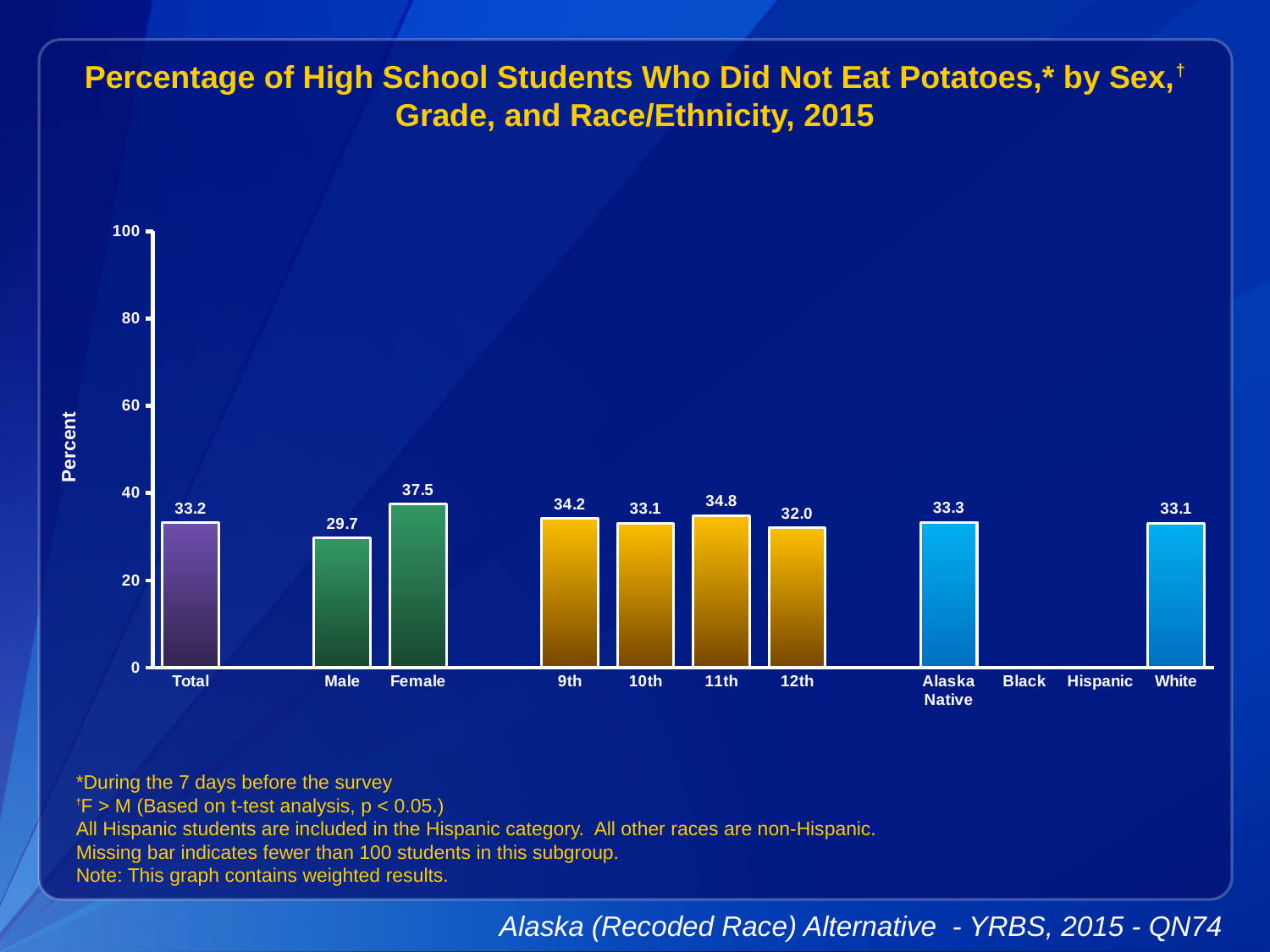
What is the difference between the Female and Male values? 7.8 Which category has the lowest value among the bars shown? Male Which is larger, the value for 9th grade or the value for 12th grade? 9th Is the value for Total greater or less than 40? less What is the value for 11th grade? 34.8 What is the difference between the 11th grade and 12th grade values? 2.8 What is the value for Female? 37.5 Which category has the highest value? Female Which categories on the x axis have no bar shown? Black and Hispanic What is the value for Male? 29.7 What is the value for Alaska Native? 33.3 What kind of chart is shown on the slide? bar chart